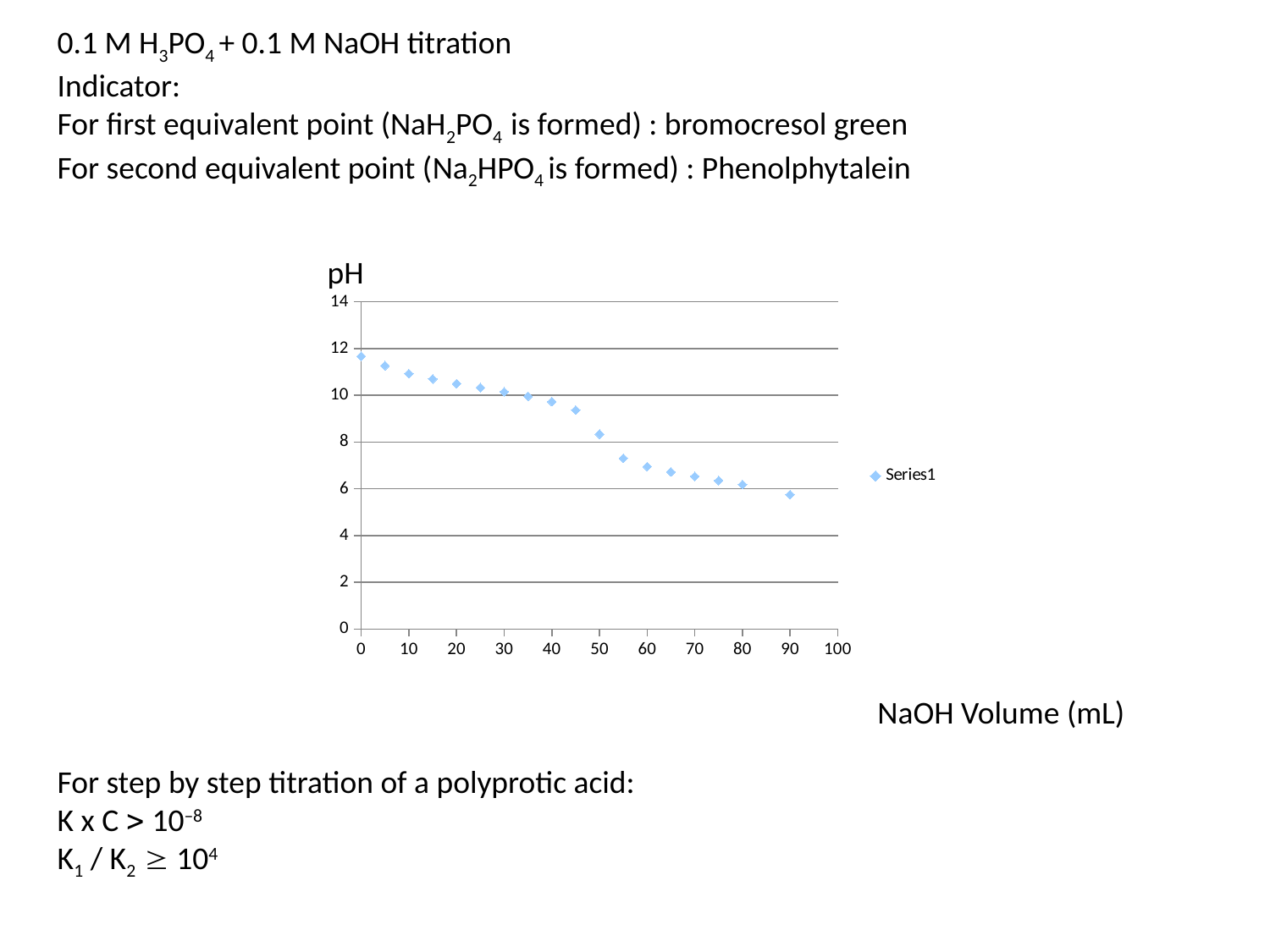
What is the label of the vertical axis? pH What kind of chart is shown on the slide? scatter chart Is the pH at 0 mL NaOH greater or less than 10? greater Is the pH at 70 mL NaOH greater or less than 8? less What is the name of the series shown in the legend? Series1 Is the pH at 90 mL NaOH greater or less than 6? less How many series does the legend list? 1 At which NaOH volume is the pH lowest? 90 At which NaOH volume is the pH highest? 0 Which has the higher pH: 10 mL NaOH or 60 mL NaOH? 10 mL NaOH Do the pH values rise or fall as the NaOH volume increases along the x axis? fall